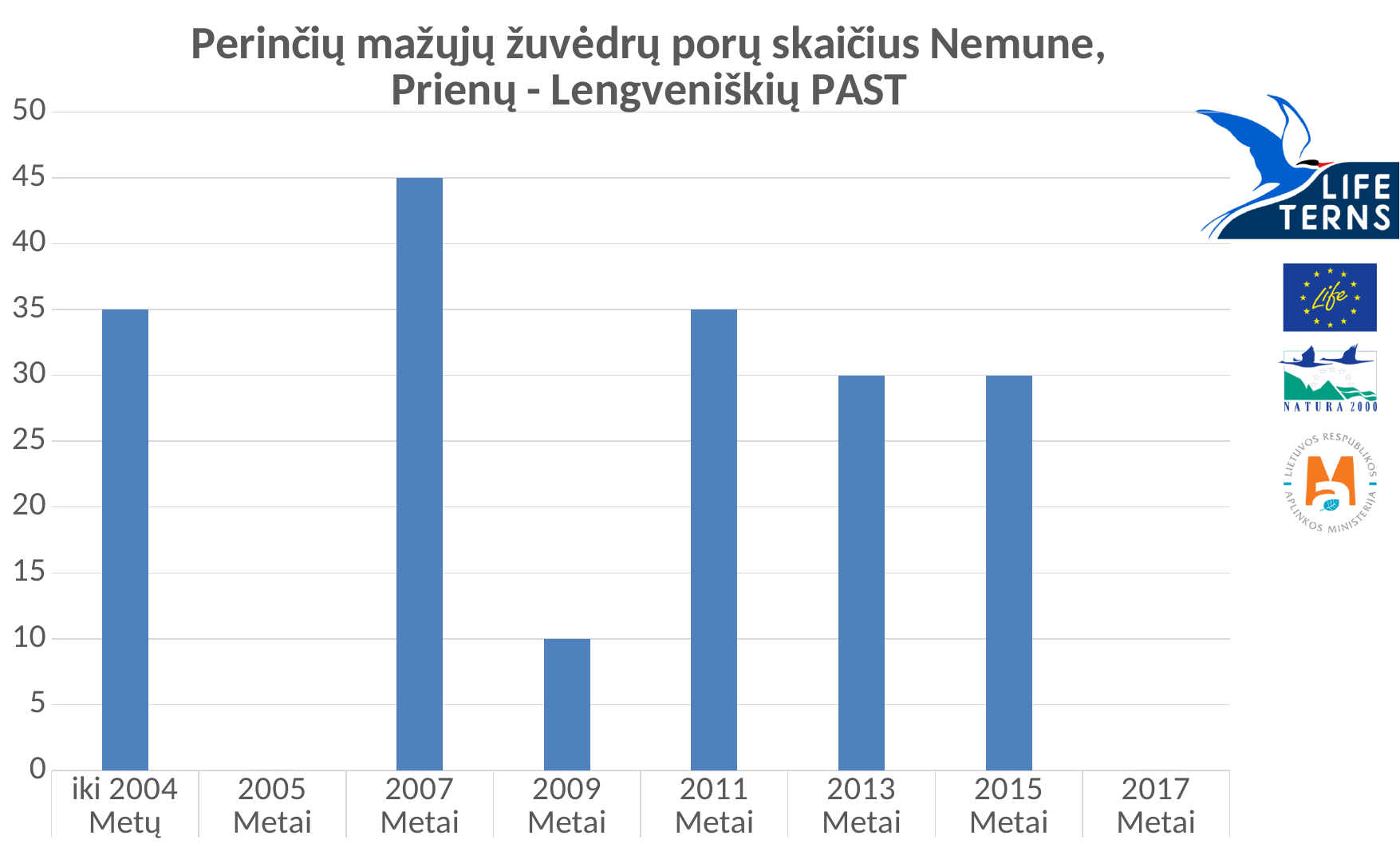
Which year has the highest value in the chart? 2007 Metai Is the value for 2007 Metai greater or less than 40? greater What is the difference between the values for 2007 Metai and 2009 Metai? 35 Among the years with a visible bar, which has the lowest value? 2009 Metai What is the value for 2007 Metai? 45 Which is larger, the value for 2011 Metai or the value for 2015 Metai? 2011 Metai What is the value for iki 2004 Metų? 35 What type of chart is shown on the slide? bar chart What is the value for 2009 Metai? 10 What is the title of the chart? Perinčių mažųjų žuvėdrų porų skaičius Nemune, Prienų - Lengveniškių PAST How many categories are shown on the x axis of the chart? 8 What is the value for 2013 Metai? 30